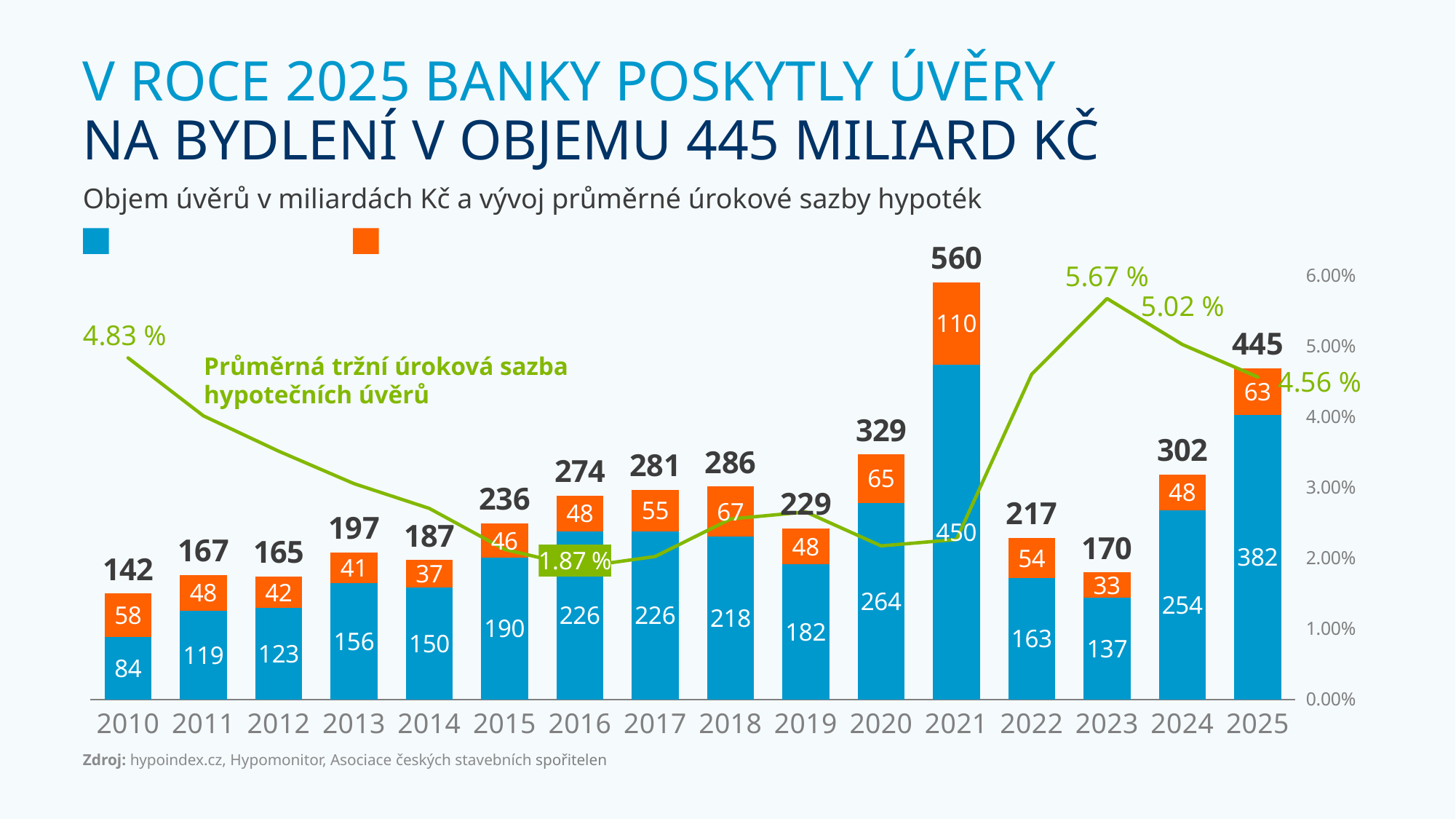
What is the value of the orange segment of the bar for 2018? 67 How many years are shown on the x axis? 16 Which year has the lowest total loan volume? 2010 What kind of chart is shown on the slide? Stacked bar chart with a line Is the interest rate line value for 2013 greater or less than 4.00%? less Which year has the larger total loan volume, 2017 or 2019? 2017 What is the difference between the total loan volumes for 2025 and 2024? 143 What is the total loan volume shown above the bar for 2021? 560 What average mortgage interest rate is labelled on the line for 2023? 5.67 % What is the value of the blue segment of the bar for 2025? 382 What average mortgage interest rate is labelled on the line for 2016? 1.87 % Which year has the highest total loan volume? 2021